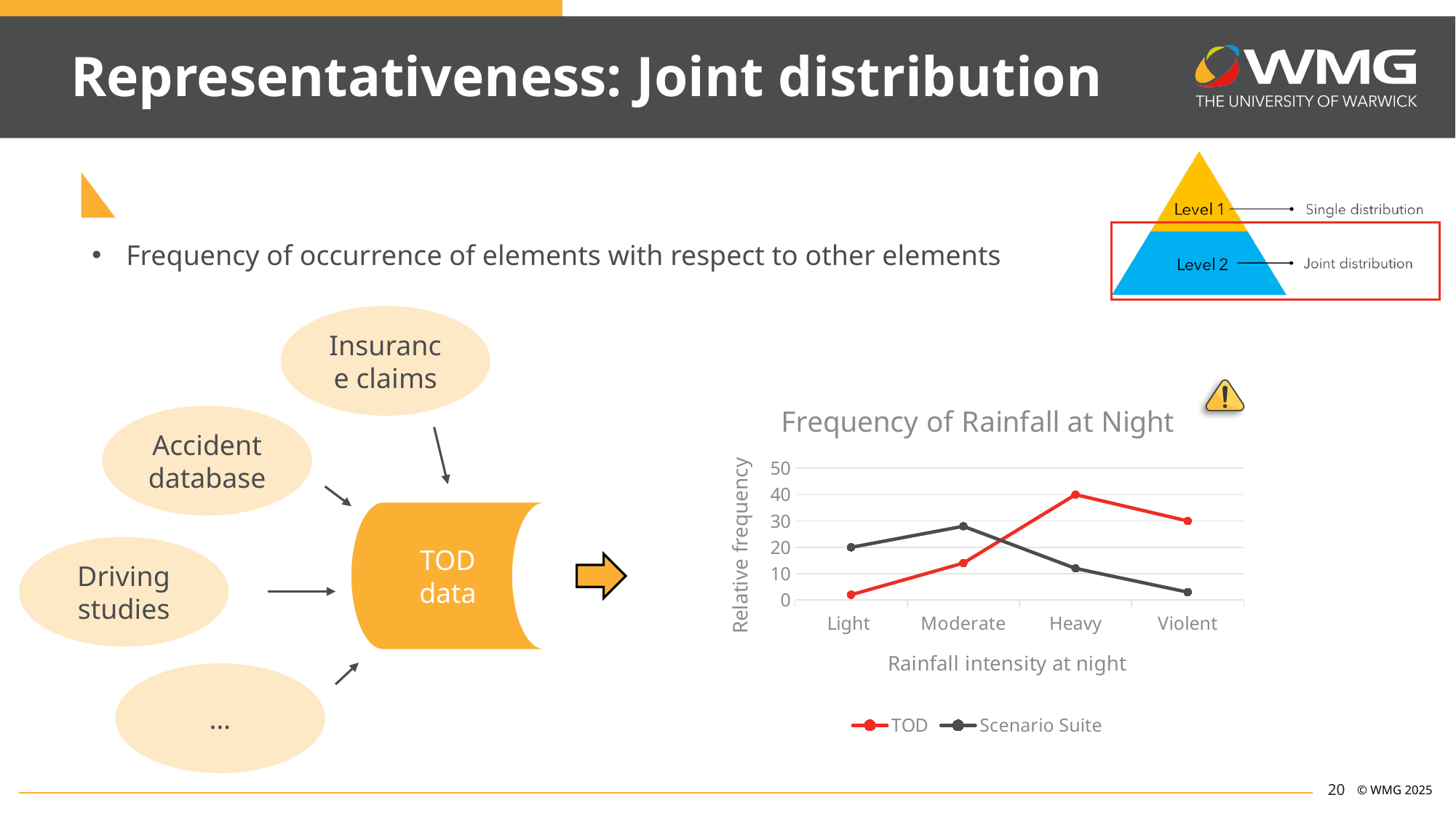
Which rainfall intensity category has the highest value for the TOD series? Heavy Which rainfall intensity category has the lowest value for the TOD series? Light What kind of chart is shown on the slide? line chart For Light rainfall, which series has the larger value, TOD or Scenario Suite? Scenario Suite What is the title of the chart? Frequency of Rainfall at Night How many rainfall intensity categories are shown on the x axis of the chart? 4 How many series does the chart legend list? 2 Which rainfall intensity category has the highest value for the Scenario Suite series? Moderate Is the Scenario Suite value for Violent rainfall greater or less than 10? less What is the label of the y axis of the chart? Relative frequency Which rainfall intensity category has the lowest value for the Scenario Suite series? Violent Is the TOD value for Heavy rainfall greater or less than 30? greater